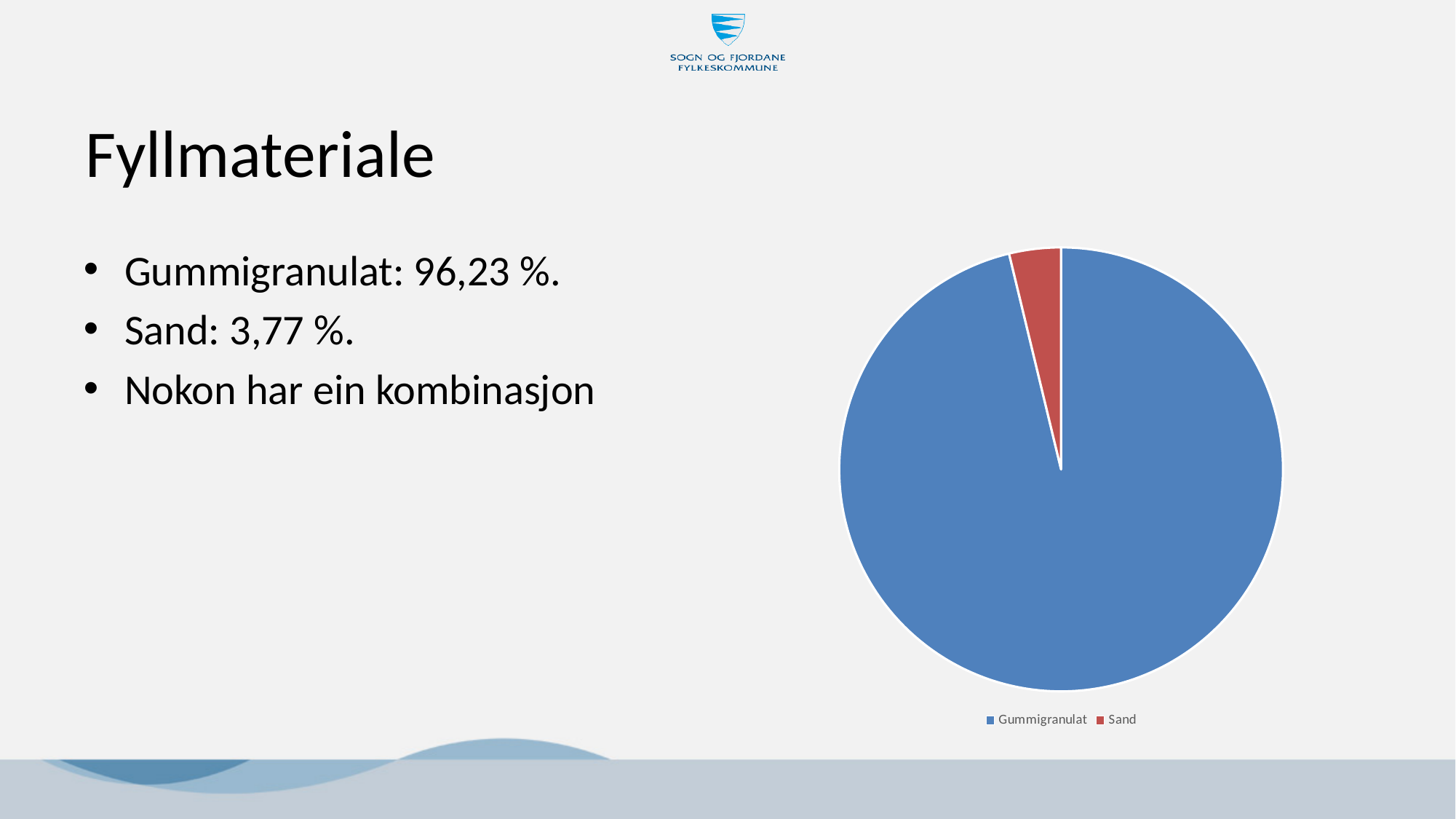
How many entries does the legend of the pie chart list? 2 What kind of chart is shown on the slide? pie chart Which category has the smallest slice in the pie chart? Sand Which category has the largest slice in the pie chart? Gummigranulat What share of the pie does Sand represent, according to the slide? 3,77 % Which slice is larger in the pie chart, Gummigranulat or Sand? Gummigranulat How many slices does the pie chart have? 2 What colour is the Sand slice in the pie chart? red What share of the pie does Gummigranulat represent, according to the slide? 96,23 % What colour is the Gummigranulat slice in the pie chart? blue